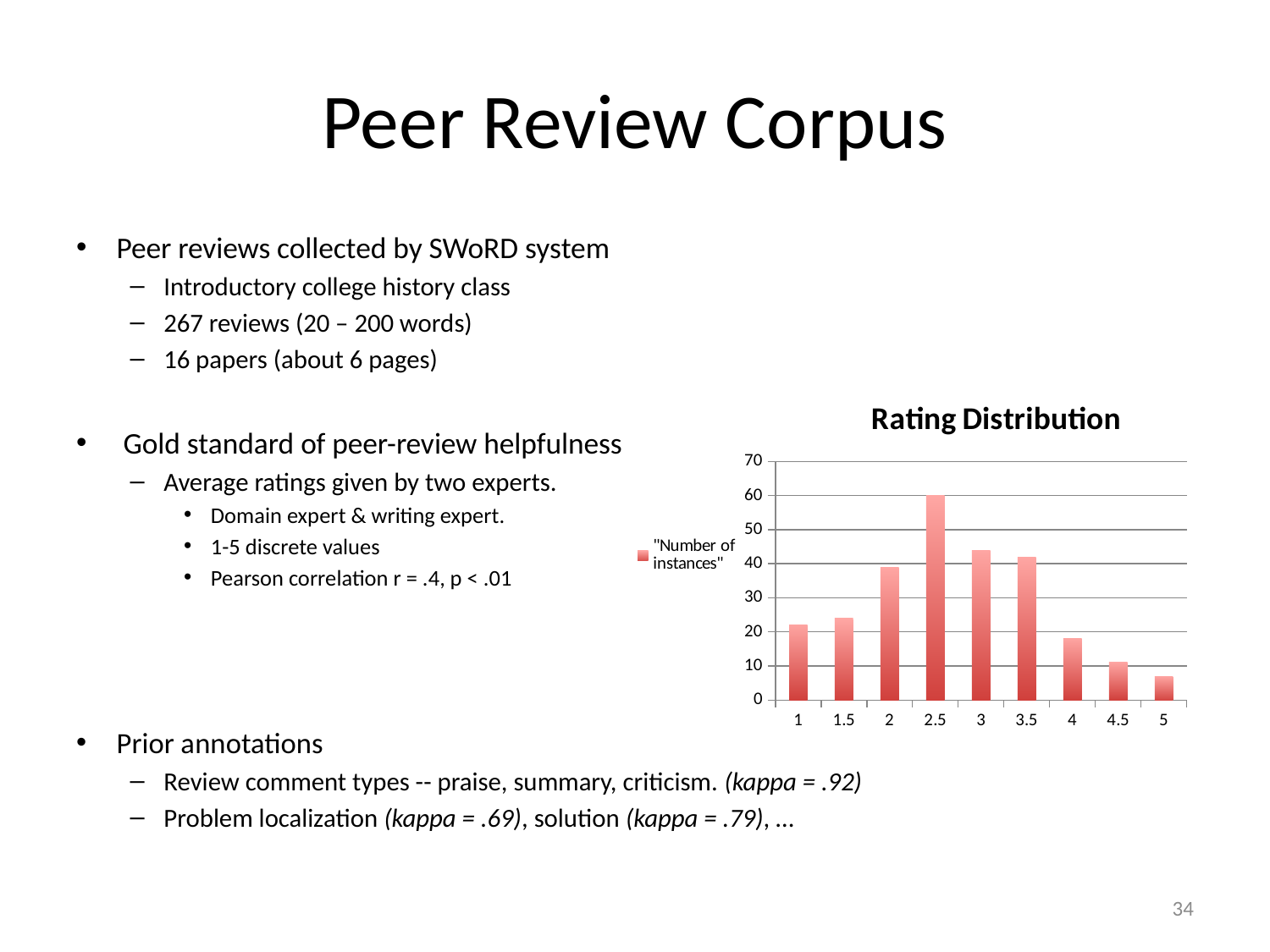
Which rating has more instances, 2 or 4? 2 Which rating has more instances, 1 or 5? 1 How many series does the chart legend list? 1 Which rating has the highest number of instances? 2.5 What kind of chart is shown on the slide? bar chart How many rating categories are shown on the x axis of the chart? 9 Is the number of instances for rating 2.5 greater or less than 50? greater Is the number of instances for rating 5 greater or less than 10? less What is the title of the chart? Rating Distribution What is the legend entry for the series in the chart? "Number of instances" Which rating has the lowest number of instances? 5 Is the number of instances for rating 2 greater or less than 30? greater